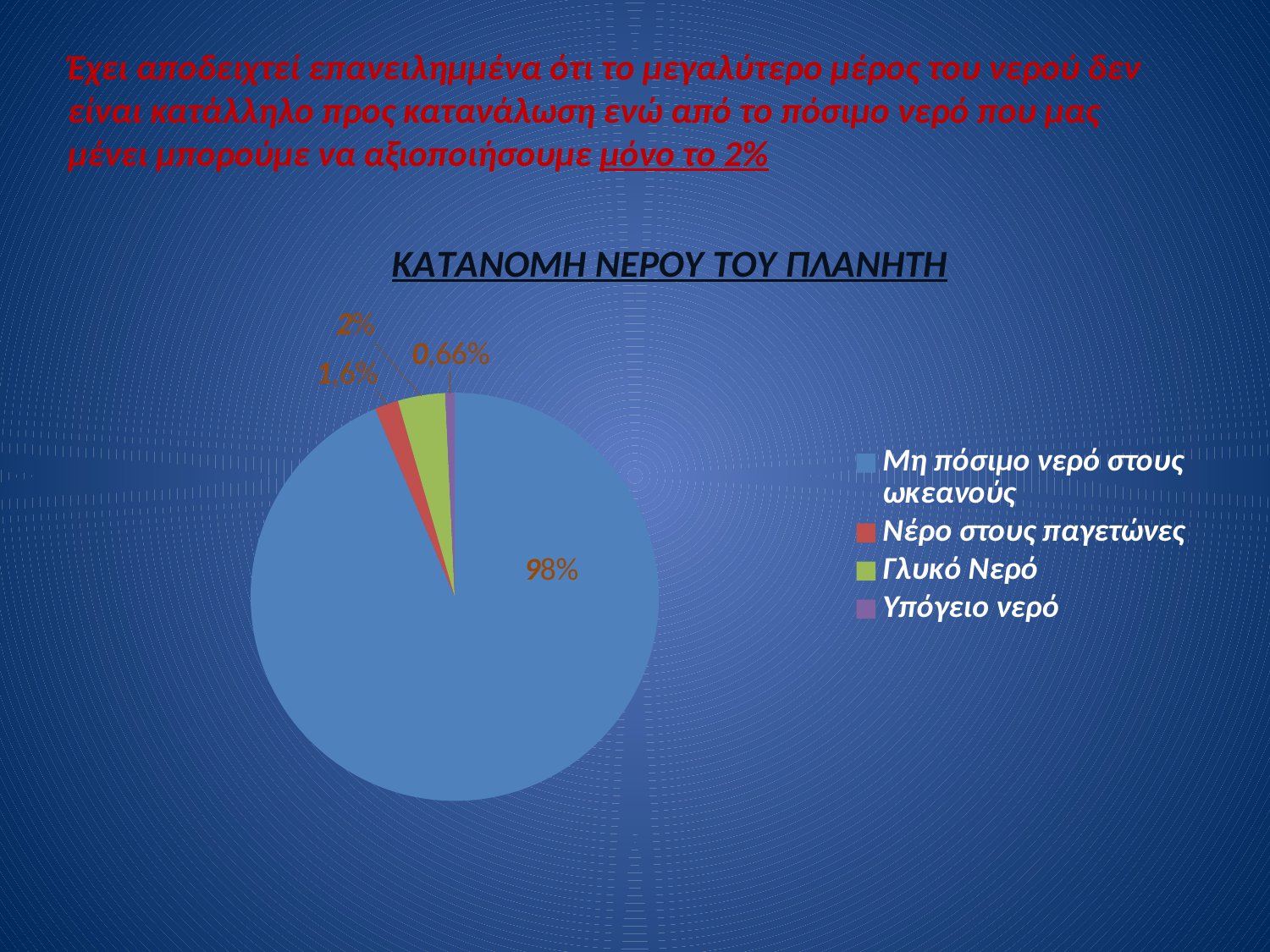
What percentage is shown for Υπόγειο νερό? 0.66% What colour is the slice for Μη πόσιμο νερό στους ωκεανούς? blue Which category has the largest share of the pie? Μη πόσιμο νερό στους ωκεανούς What percentage is shown for Μη πόσιμο νερό στους ωκεανούς? 98% What type of chart is shown on the slide? pie chart What percentage is shown for Γλυκό Νερό? 2% Which is larger, the share for Γλυκό Νερό or the share for Νέρο στους παγετώνες? Γλυκό Νερό What percentage is shown for Νέρο στους παγετώνες? 1.6% Which category has the smallest share of the pie? Υπόγειο νερό How many slices does the pie chart have? 4 What is the title of the chart? ΚΑΤΑΝΟΜΗ ΝΕΡΟΥ ΤΟΥ ΠΛΑΝΗΤΗ How many entries does the legend list? 4